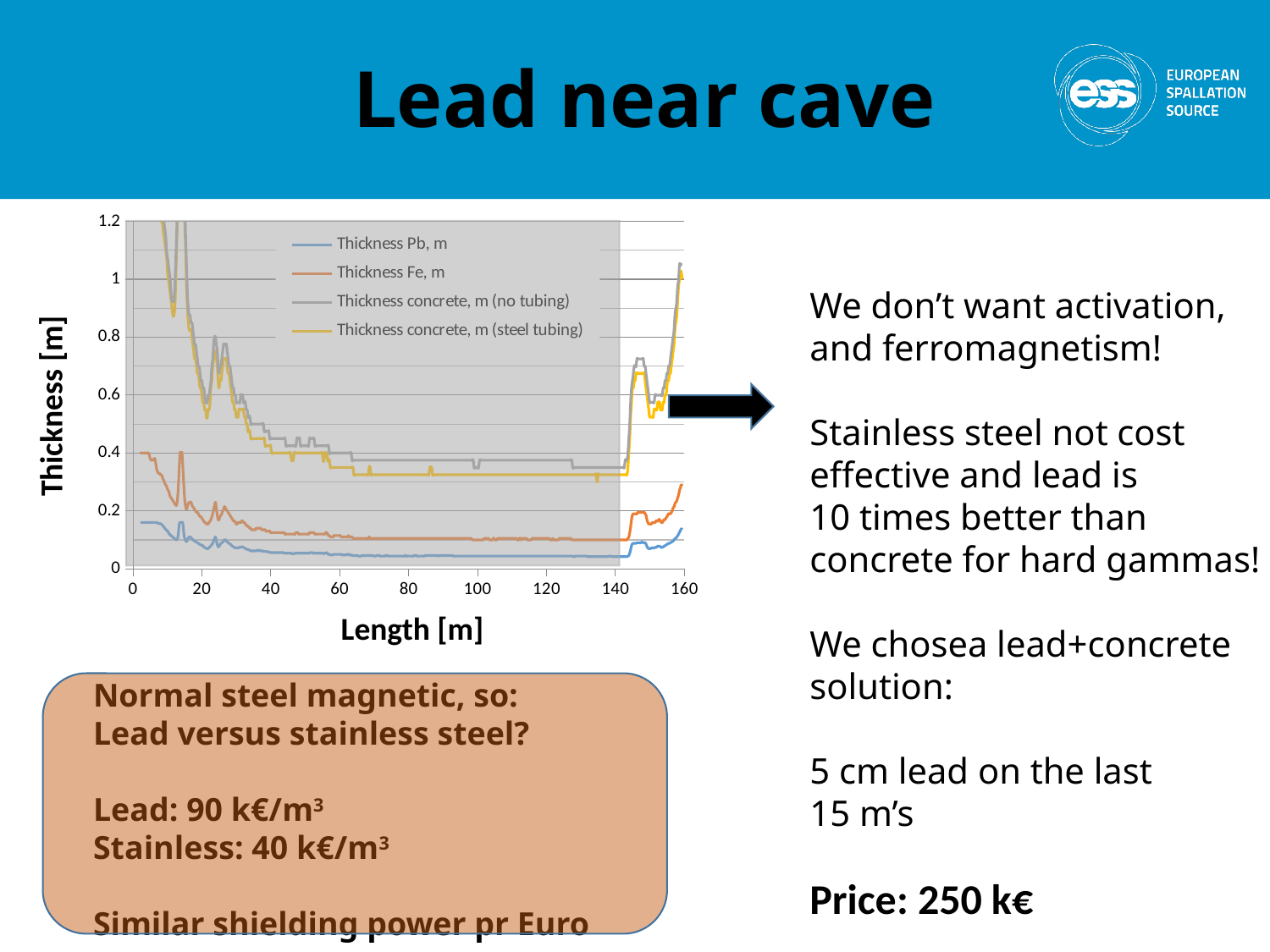
What is the title of the x axis of the chart? Length [m] Is the value of Thickness Fe, m at a length of 80 m greater or less than 0.2? less Between lengths of 0 m and 60 m, does the Thickness Fe, m series generally rise or fall? fall At a length of 80 m, which is larger: Thickness Pb, m or Thickness concrete, m (no tubing)? Thickness concrete, m (no tubing) Is the value of Thickness Fe, m at a length of 160 m greater or less than 0.2? greater What is the title of the y axis of the chart? Thickness [m] What kind of chart is shown on the slide? line chart Which series has the lowest values across the chart? Thickness Pb, m How many series does the chart legend list? 4 Is the value of Thickness concrete, m (no tubing) at a length of 100 m greater or less than 0.2? greater At a length of 80 m, which is larger: Thickness Fe, m or Thickness Pb, m? Thickness Fe, m